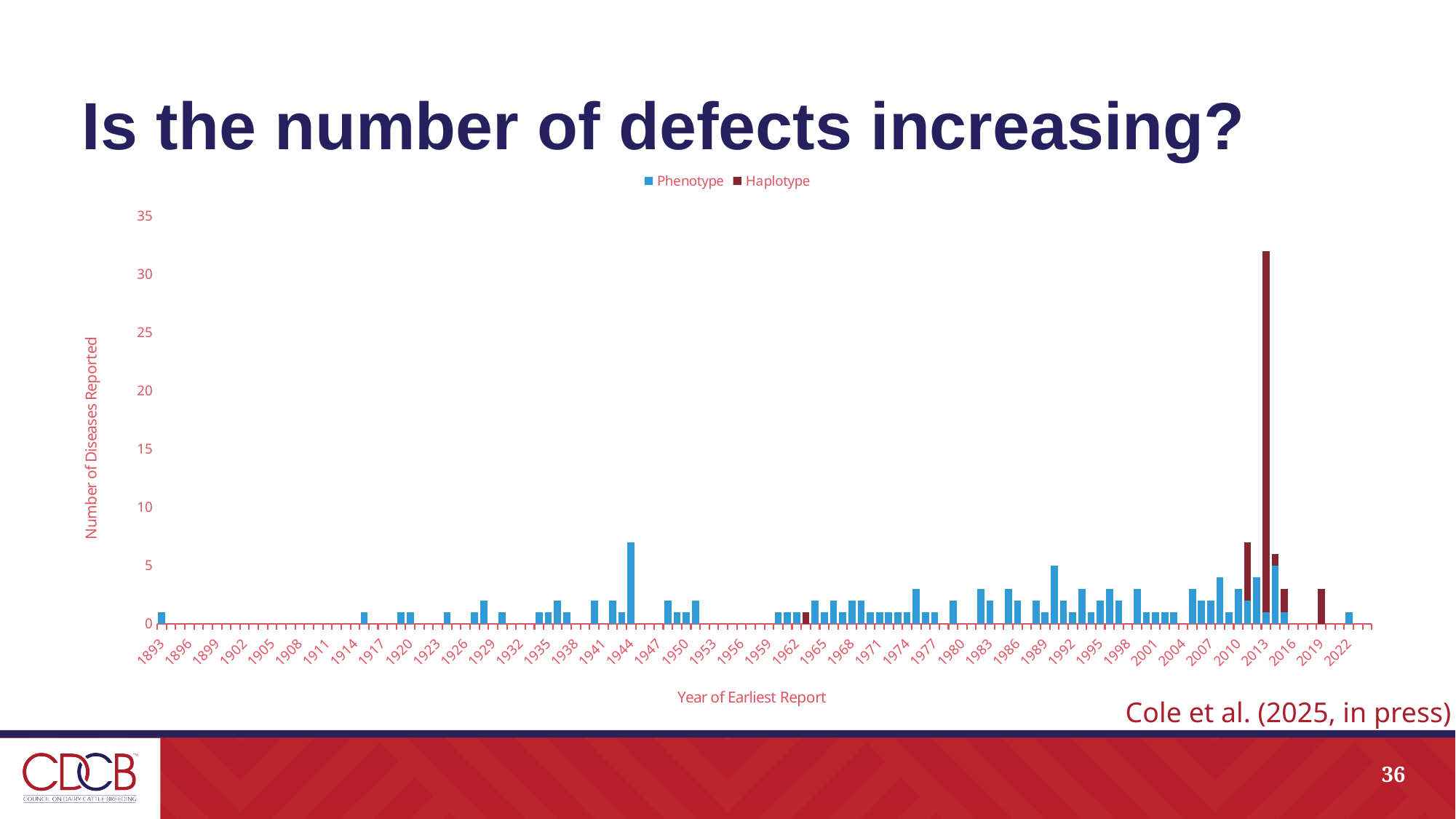
Is the Phenotype value for 1893 greater or less than 5? less Which is larger, the Phenotype bar for 1944 or the Phenotype bar for 1893? 1944 What is the highest value shown on the y axis? 35 What are the two series named in the legend? Phenotype and Haplotype How many series does the legend list? 2 Is the Phenotype value for 1944 greater or less than 5? greater Is the Phenotype value for 1989 greater or less than 10? less Which series does the tallest bar on the chart belong to? Haplotype What kind of chart is shown on the slide? Bar chart What is the title of the y axis? Number of Diseases Reported